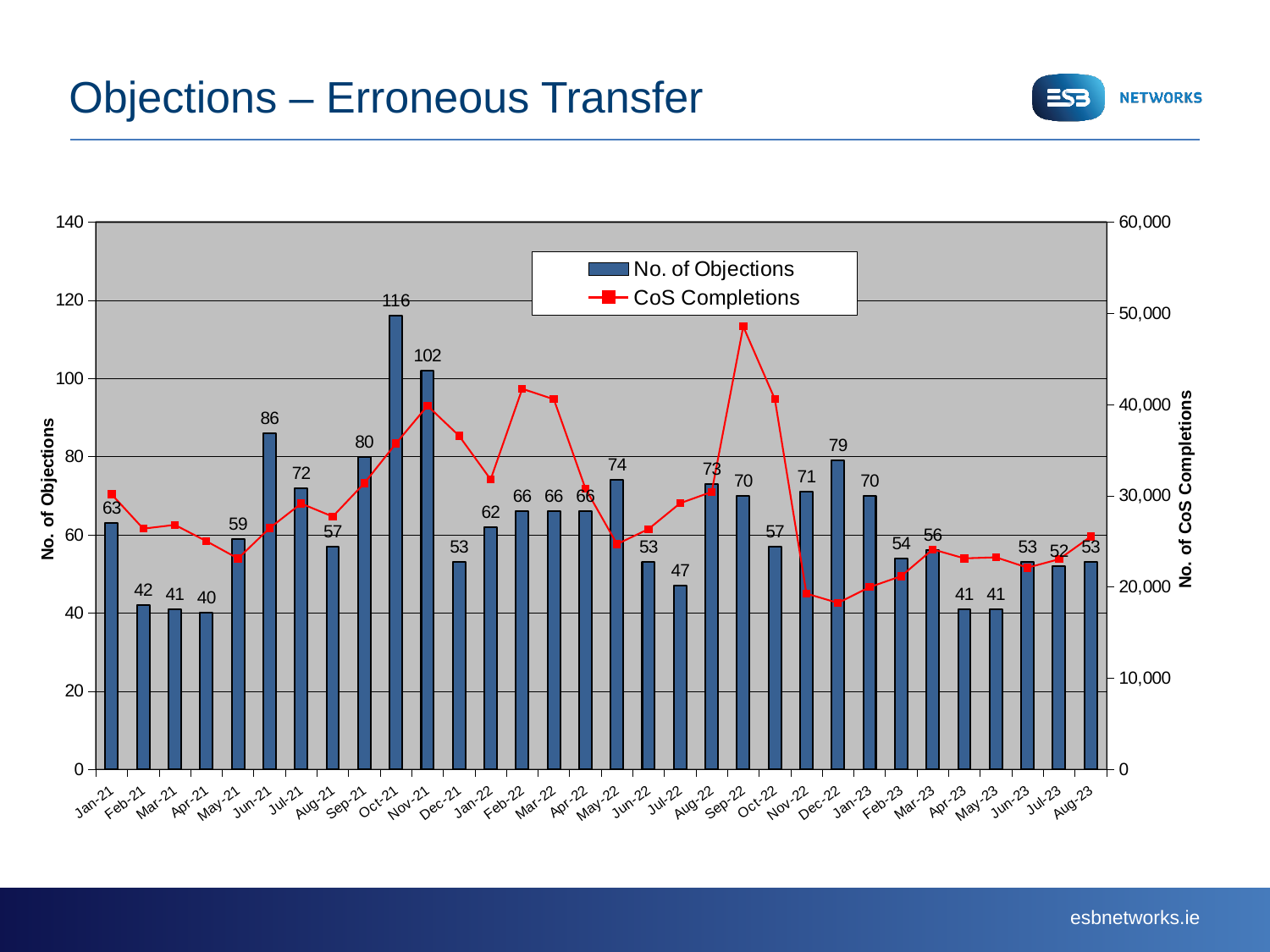
How many months are shown on the x axis? 32 Which month has the highest number of objections? Oct-21 What is the difference in the number of objections between Oct-21 and Nov-21? 14 Is the value of CoS Completions for Dec-22 greater or less than 20,000? less What is the number of objections for Oct-21? 116 What is the number of objections for Jun-21? 86 Which month has the lowest number of objections? Apr-21 What is the number of objections for Aug-23? 53 How many series does the legend list? 2 Is the value of CoS Completions for Sep-22 greater or less than 40,000? greater What is the label of the right-hand vertical axis? No. of CoS Completions Which month has more objections, Dec-22 or Jan-23? Dec-22